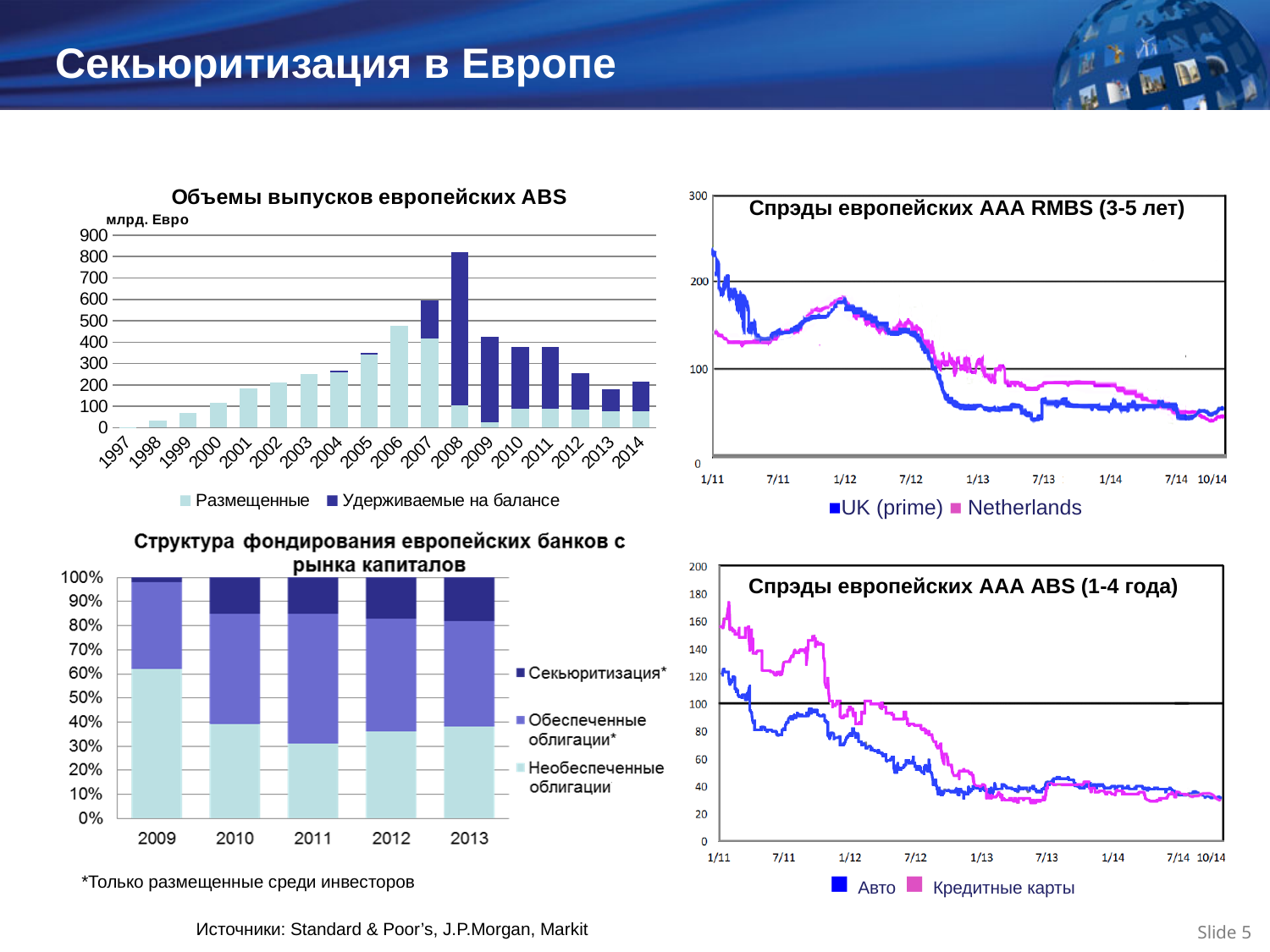
In the chart 'Спрэды европейских AAA ABS (1-4 года)', do the values for Кредитные карты generally rise or fall from 1/11 to 10/14? fall In the chart 'Объемы выпусков европейских ABS', how many years are shown on the x axis? 18 In the chart 'Объемы выпусков европейских ABS', which total bar is larger, 2007 or 2012? 2007 How many series does the legend of 'Объемы выпусков европейских ABS' list? 2 What kind of chart is 'Объемы выпусков европейских ABS'? bar chart In the chart 'Объемы выпусков европейских ABS', is the total bar for 2008 greater or less than 700? greater In the chart 'Объемы выпусков европейских ABS', is the total bar for 2014 greater or less than 300? less Which two series are listed in the legend of 'Спрэды европейских AAA RMBS (3-5 лет)'? UK (prime) and Netherlands In the chart 'Структура фондирования европейских банков с рынка капиталов', how many years are shown? 5 How many series does the legend of 'Структура фондирования европейских банков с рынка капиталов' list? 3 What kind of chart is 'Спрэды европейских AAA RMBS (3-5 лет)'? line chart In the chart 'Объемы выпусков европейских ABS', which year has the highest total bar? 2008